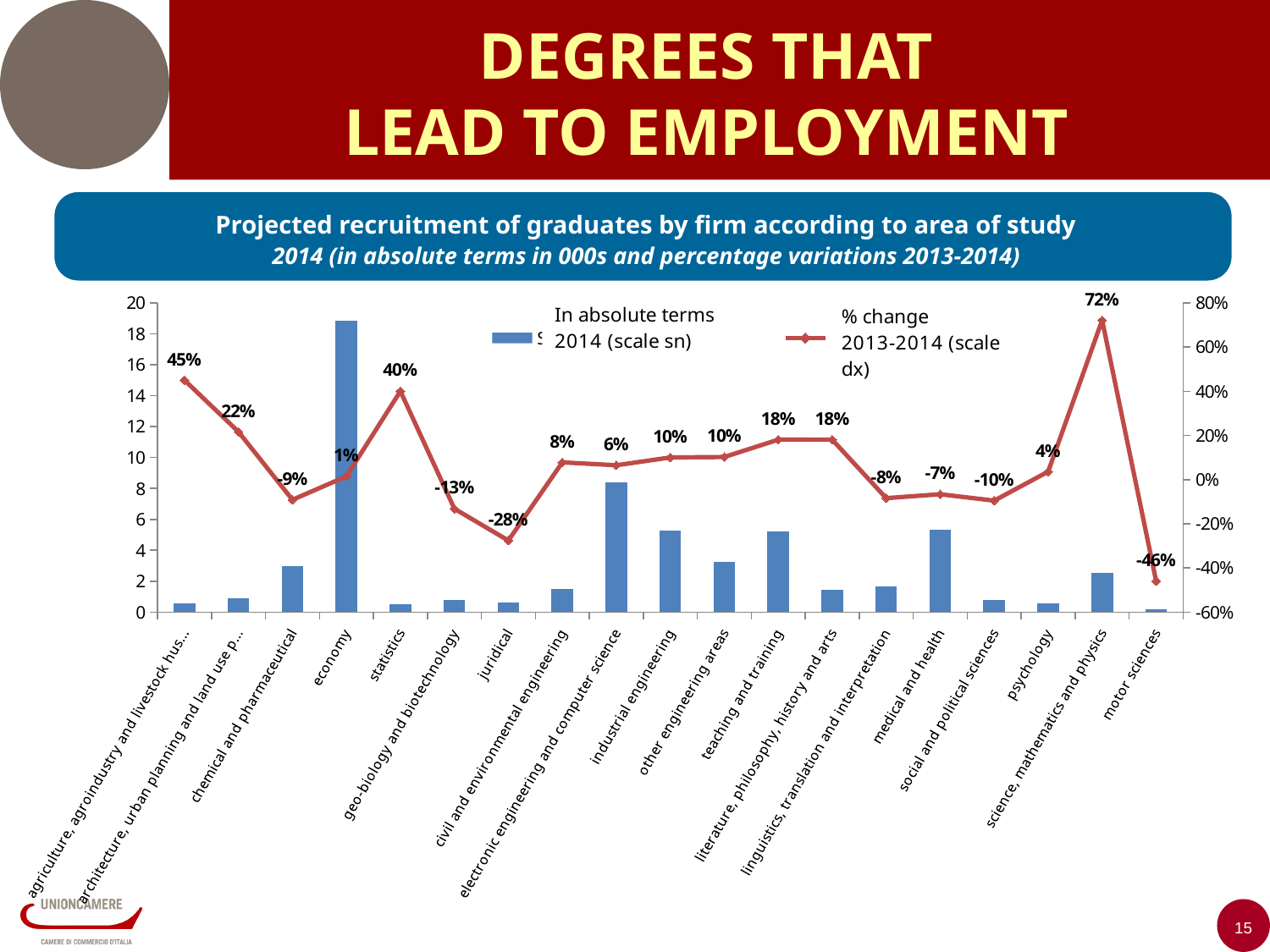
How many areas of study are shown on the x axis of the chart? 19 Is the absolute-terms bar for economy greater or less than 18? greater What is the difference in percentage points between the % change for agriculture, agroindustry and livestock and the % change for architecture, urban planning and land use? 23 percentage points How many series does the chart's legend list? 2 Which area of study has the tallest bar for recruitment in absolute terms in 2014? economy What is the percentage change 2013-2014 shown for science, mathematics and physics? 72% Which area of study has the lowest percentage change 2013-2014? motor sciences Which area of study has the highest percentage change 2013-2014? science, mathematics and physics What is the percentage change 2013-2014 shown for juridical? -28% What kind of chart is shown on the slide? Combination bar and line chart What is the percentage change 2013-2014 shown for economy? 1% Which has a larger percentage change 2013-2014, statistics or geo-biology and biotechnology? statistics